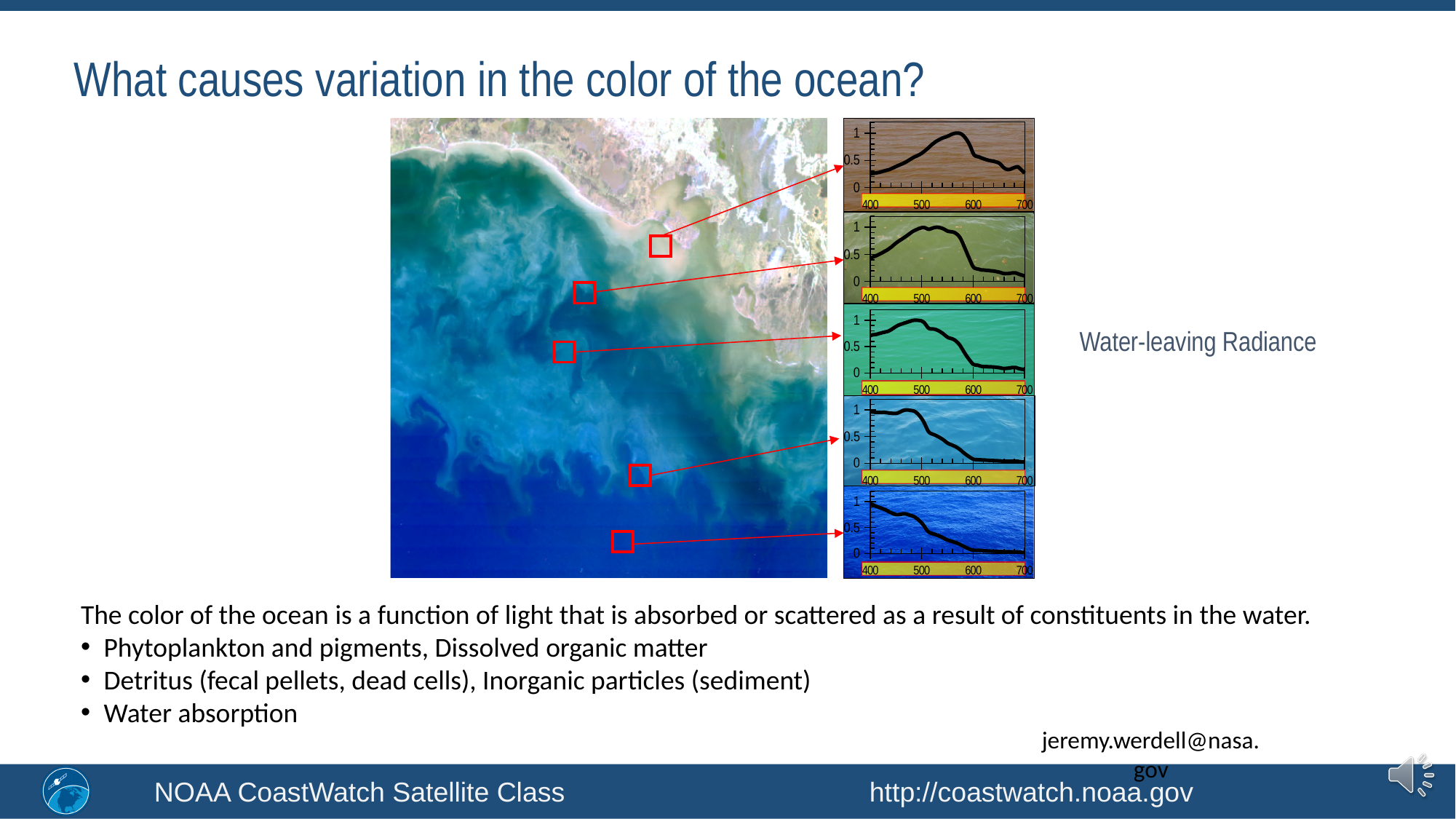
In the bottom (dark blue) chart, which is larger: the value at 400 or the value at 700? 400 In the bottom (dark blue) chart, does the line rise or fall as the x axis goes from 400 to 700? fall What kind of chart are the five small charts on the right side of the slide? line chart In the bottom (dark blue) chart, is the value at 400 greater or less than 0.5? greater In the fourth chart from the top (light blue), does the line rise or fall as the x axis goes from 400 to 700? fall How many small spectrum charts are shown to the right of the satellite image? 5 In the fourth chart from the top (light blue), is the value at 700 greater or less than 0.5? less In the bottom (dark blue) chart, is the value at 700 greater or less than 0.5? less In the topmost (brown) chart, which is larger: the value at 400 or the value at 550? 550 What is the highest x-axis tick label shown on the topmost chart? 700 What is the lowest x-axis tick label shown on the bottom chart? 400